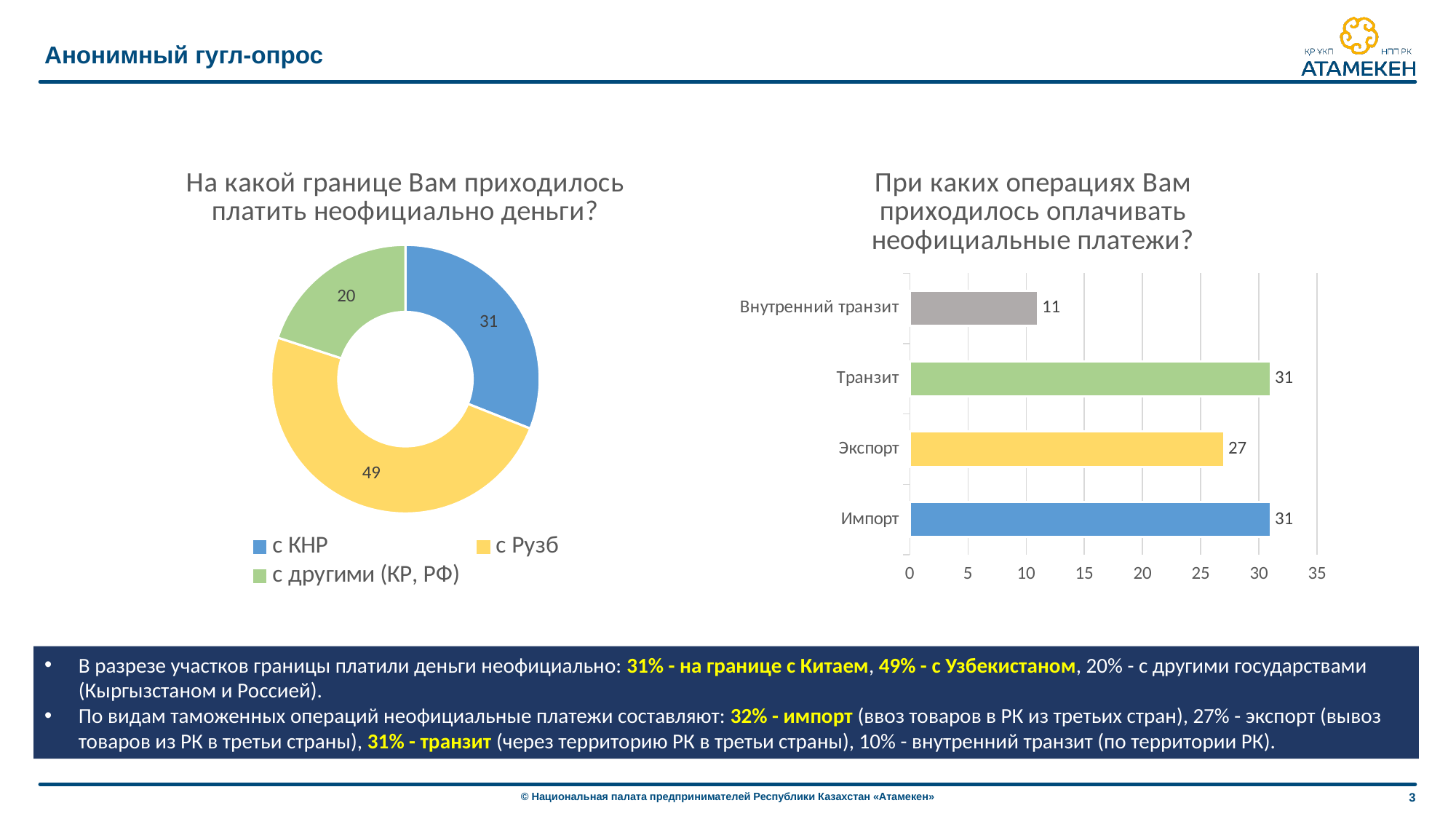
In the left chart, what is the difference between the values for 'с Рузб' and 'с КНР'? 18 In the left chart, how many entries does the legend list? 3 In the left chart, which segment is the smallest? с другими (КР, РФ) In the right chart, what is the value for 'Экспорт'? 27 In the right chart, which is larger: the value for 'Транзит' or the value for 'Экспорт'? Транзит In the left chart, what is the value for the segment 'с КНР'? 31 What kind of chart is the left chart? Doughnut (pie) chart In the left chart, what is the value for the segment 'с Рузб'? 49 How many categories are shown in the right chart? 4 In the left chart, which segment is the largest? с Рузб In the right chart, which category has the lowest value? Внутренний транзит In the right chart, what is the value for 'Внутренний транзит'? 11